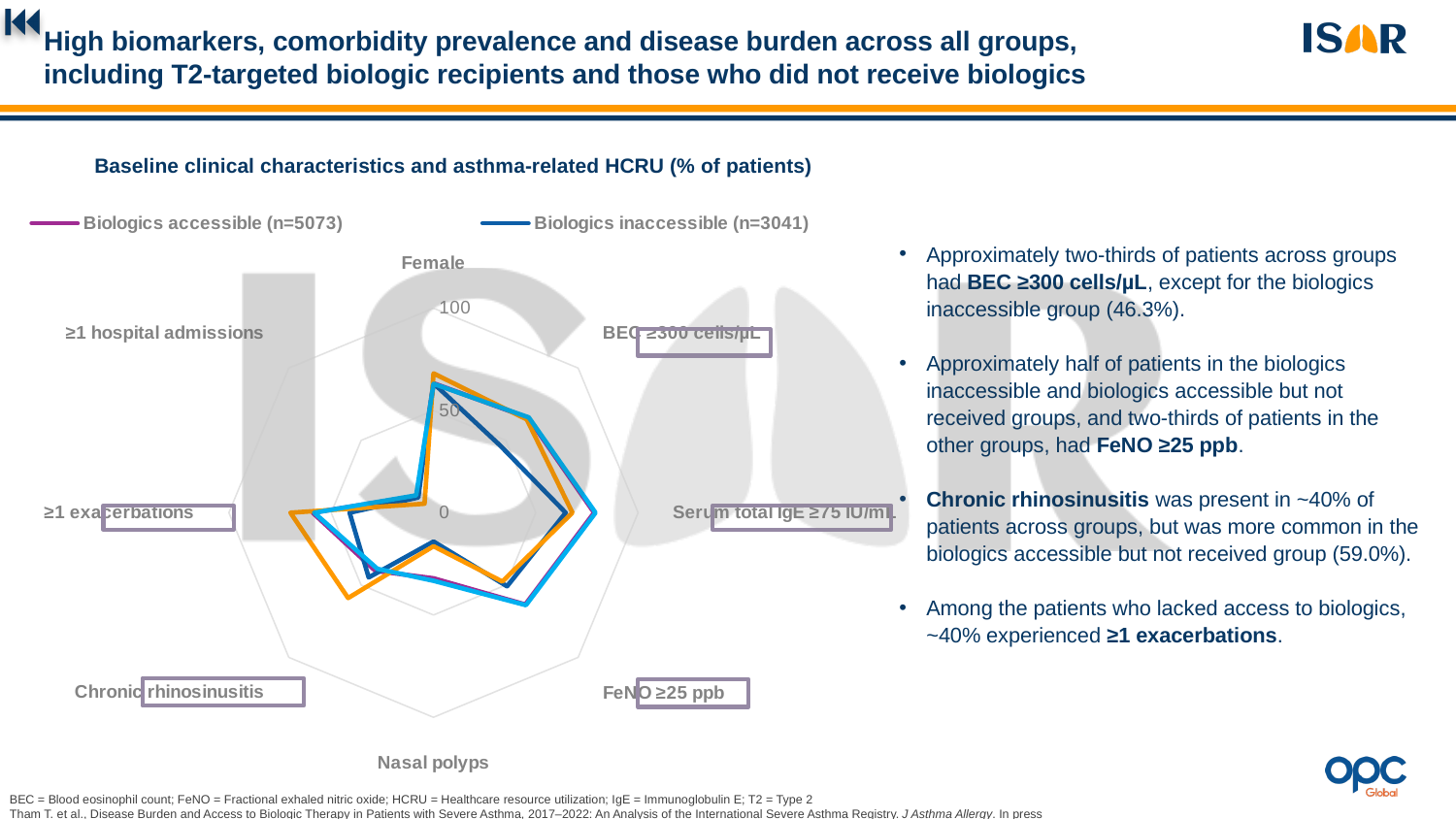
Is the value for ≥1 hospital admissions in the Biologics accessible group greater or less than 50? less For the Biologics accessible group, which category has the highest value? Serum total IgE ≥75 IU/mL Is the value for Serum total IgE ≥75 IU/mL in the Biologics accessible group greater or less than 50? greater What is the title of the chart? Baseline clinical characteristics and asthma-related HCRU (% of patients) Is the value for Female in the Biologics accessible group greater or less than 50? greater How many categories (axes) does the radar chart have? 8 What kind of chart is shown on the slide? Radar chart For the Biologics accessible group, which is larger: the value for Female or the value for Nasal polyps? Female What is the sample size (n) given in the legend for the Biologics accessible group? 5073 How many series does the chart legend list? 2